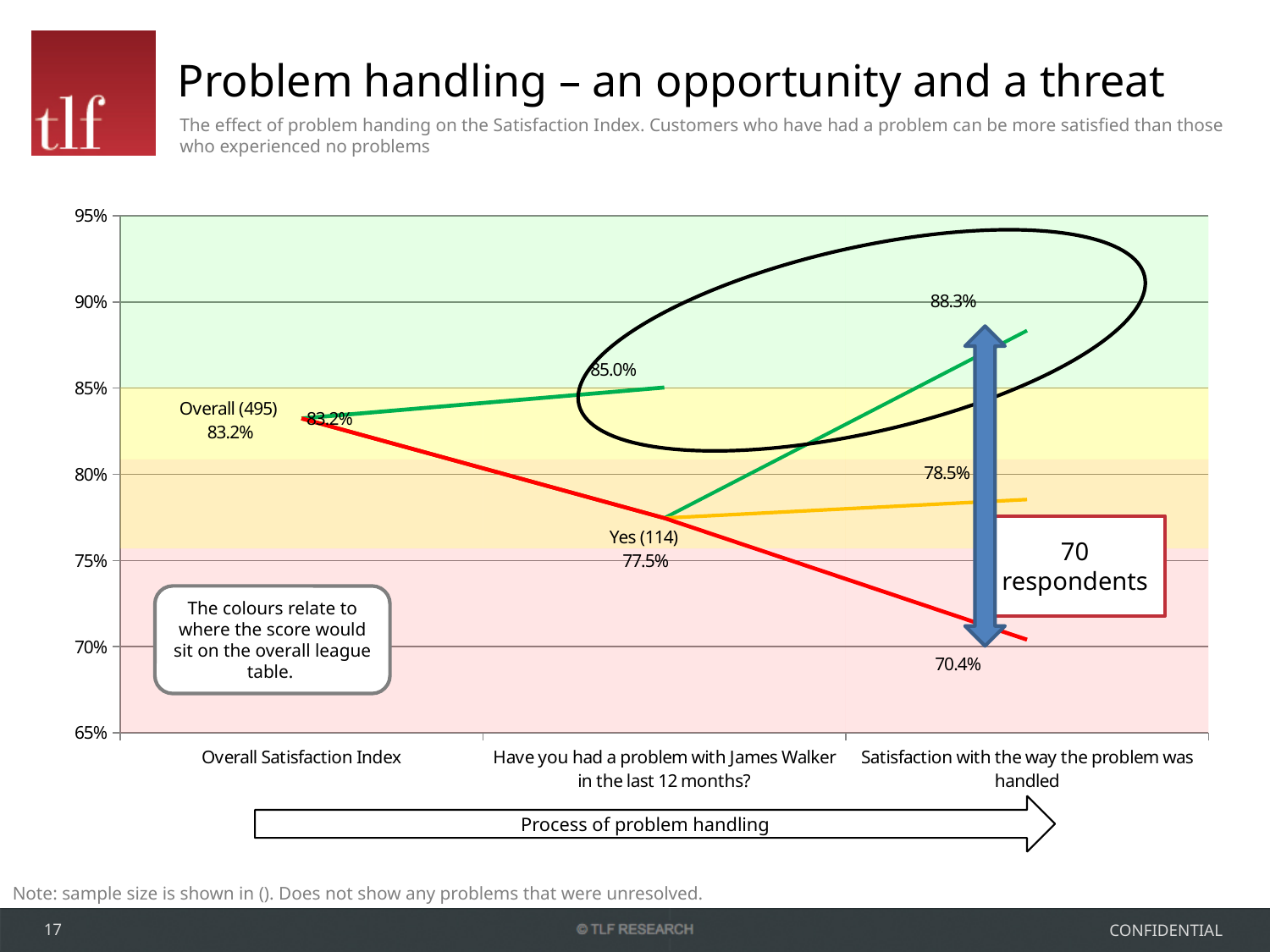
What is the Overall Satisfaction Index value shown on the chart? 83.2% What is the sample size shown in brackets for the Overall category? 495 What kind of chart is shown on the slide? line chart What is the lowest data label shown anywhere on the chart? 70.4% Is the value for Yes (114) greater or less than 80%? less Which is larger: the 85.0% value or the Overall (495) value of 83.2%? 85.0% What is the difference between the highest (88.3%) and lowest (70.4%) values under 'Satisfaction with the way the problem was handled'? 17.9 percentage points What is the highest data label shown anywhere on the chart? 88.3% What is the satisfaction value for customers who answered Yes (114) to having had a problem in the last 12 months? 77.5% What is the lowest value plotted under 'Satisfaction with the way the problem was handled'? 70.4% How many categories are shown on the x axis of the chart? 3 What is the highest value plotted under 'Satisfaction with the way the problem was handled'? 88.3%